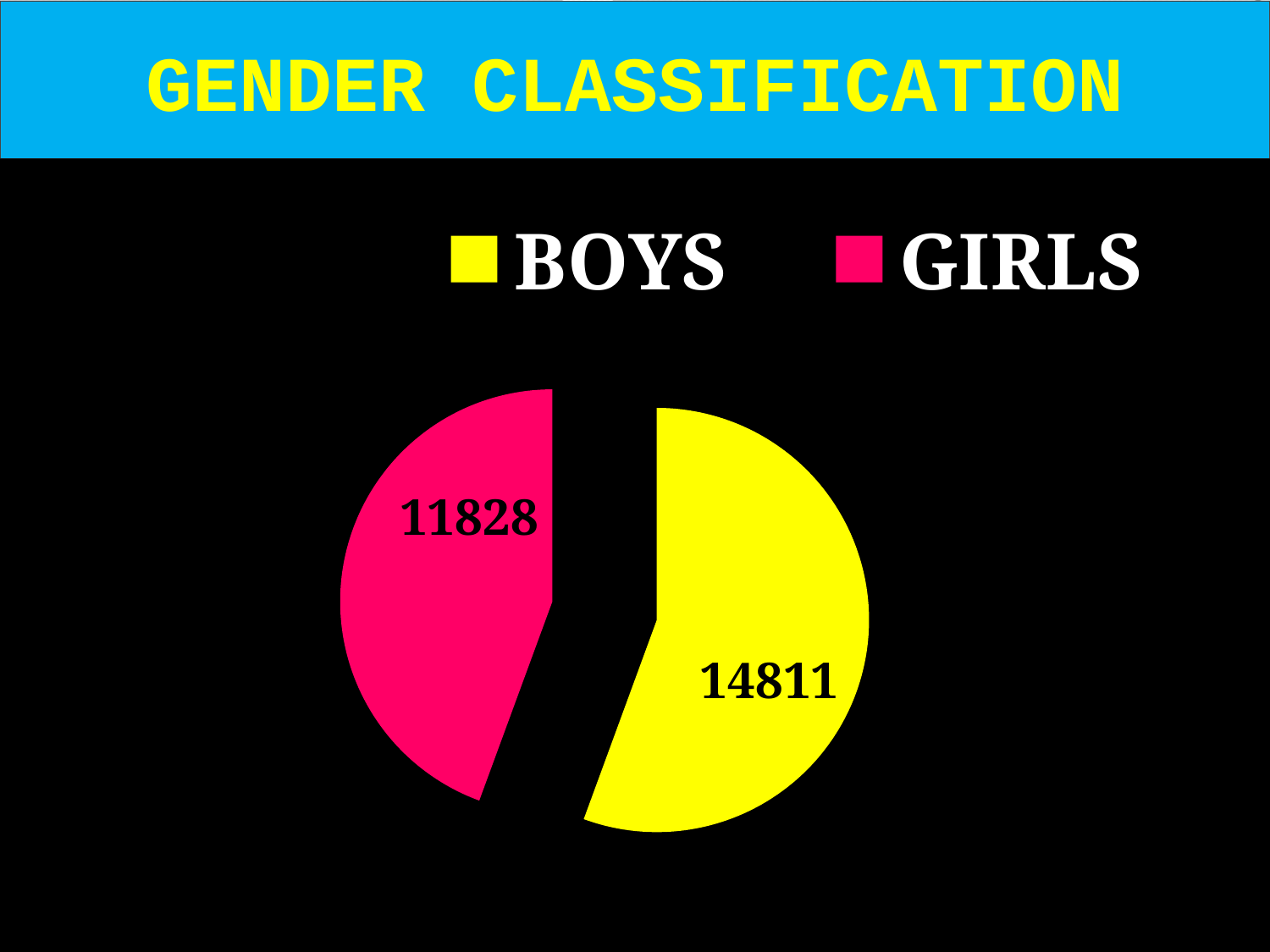
Which category has the smallest slice of the pie chart? GIRLS What share of the pie does the BOYS slice represent, to one decimal place? 55.6% What is the difference between the BOYS value and the GIRLS value? 2983 What is the total of the two slices in the pie chart? 26639 What kind of chart is shown on the slide? Pie chart Which is larger, the value for BOYS or the value for GIRLS? BOYS What is the value for GIRLS in the pie chart? 11828 What colour is the GIRLS slice in the pie chart? Pink How many slices does the pie chart have? 2 How many entries does the legend list? 2 Which category has the largest slice of the pie chart? BOYS What is the value for BOYS in the pie chart? 14811